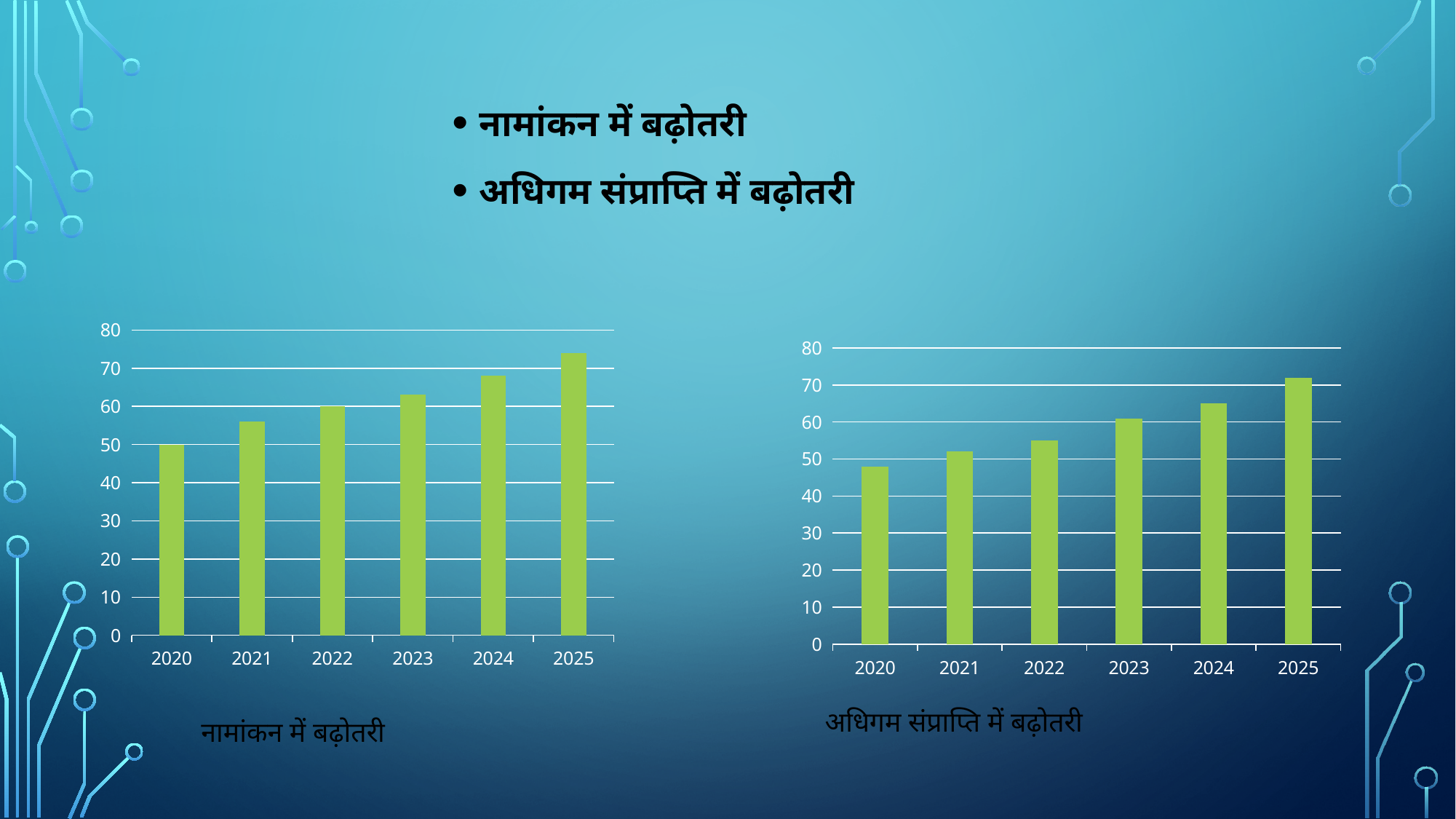
In the right chart (अधिगम संप्राप्ति में बढ़ोतरी), which is larger, the value for 2023 or the value for 2021? 2023 What is the title shown below the right chart? अधिगम संप्राप्ति में बढ़ोतरी In the right chart (अधिगम संप्राप्ति में बढ़ोतरी), is the value for 2020 greater or less than 50? less In the left chart (नामांकन में बढ़ोतरी), is the value for 2025 greater or less than 70? greater In the left chart (नामांकन में बढ़ोतरी), which year has the highest bar? 2025 In the left chart (नामांकन में बढ़ोतरी), which year has the lowest bar? 2020 In the right chart (अधिगम संप्राप्ति में बढ़ोतरी), which year has the highest bar? 2025 In the right chart (अधिगम संप्राप्ति में बढ़ोतरी), which year has the lowest bar? 2020 In the left chart (नामांकन में बढ़ोतरी), what is the value for 2020? 50 In the left chart (नामांकन में बढ़ोतरी), do the values rise or fall from 2020 to 2025? rise In the left chart (नामांकन में बढ़ोतरी), how many years are shown on the x axis? 6 What kind of chart is the left chart titled नामांकन में बढ़ोतरी? bar chart